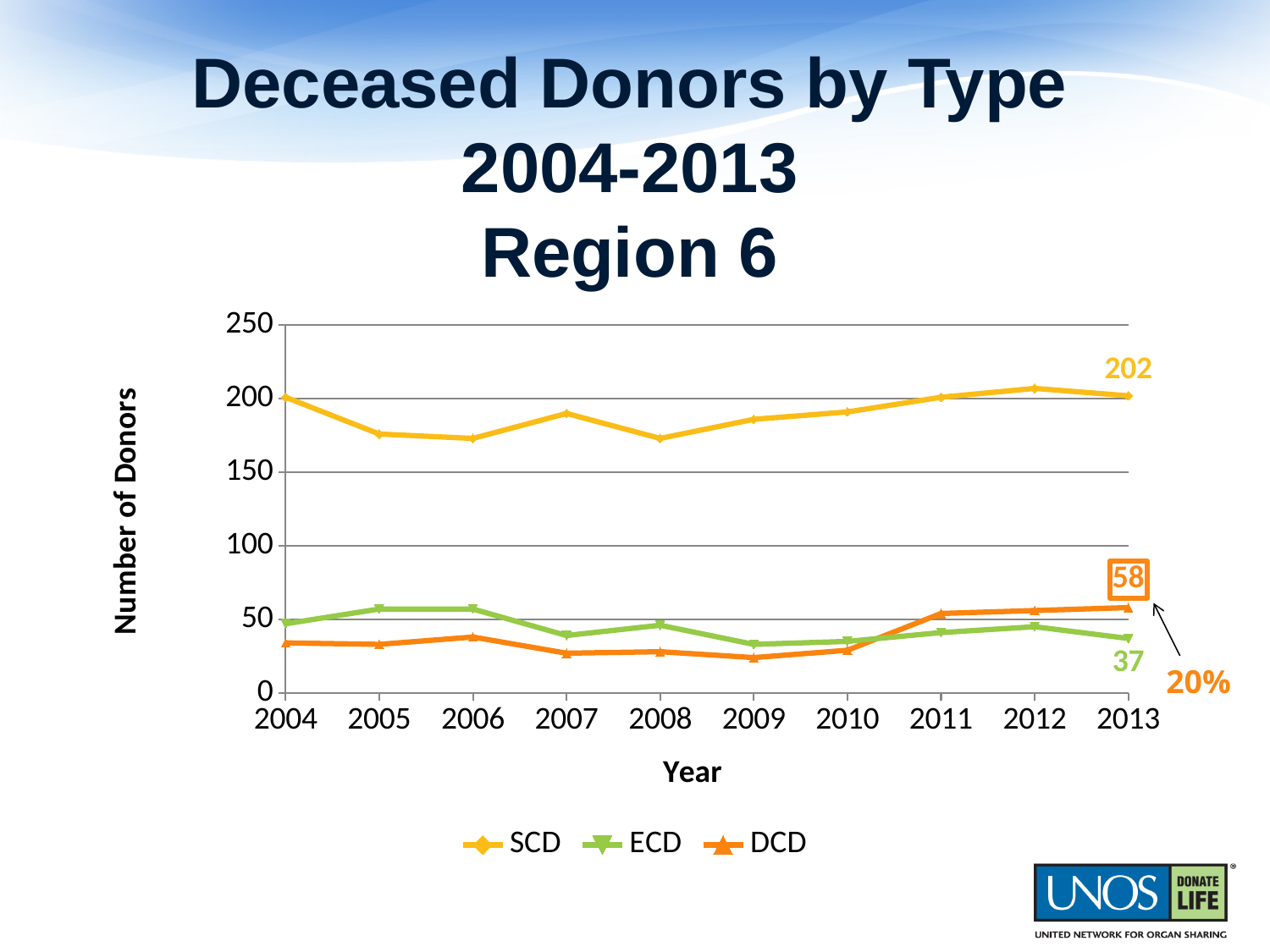
Is the value for SCD in 2005 greater or less than 200? less Which series has the highest value in 2013? SCD How many years are shown on the x axis? 10 What is the value for SCD in 2013? 202 What kind of chart is shown on the slide? Line chart What is the difference between the DCD and ECD values in 2013? 21 What is the difference between the SCD and DCD values in 2013? 144 What is the value for ECD in 2013? 37 In 2013, which is larger, DCD or ECD? DCD How many series does the legend list? 3 What is the value for DCD in 2013? 58 Is the value for DCD in 2009 greater or less than 50? less